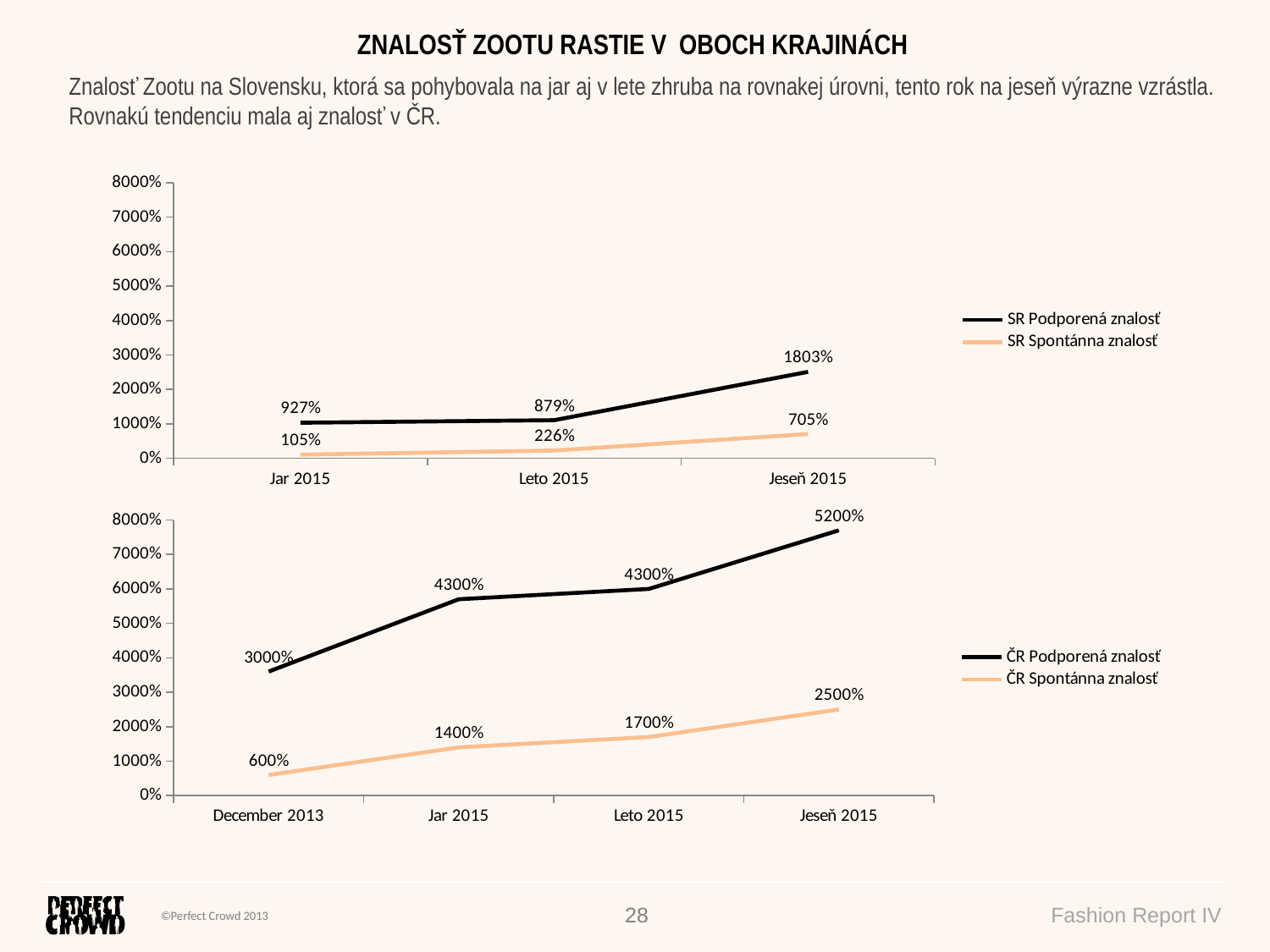
In the bottom chart, what is the value of ČR Podporená znalosť for December 2013? 3000% In the top chart, what is the difference between SR Podporená znalosť and SR Spontánna znalosť for Jar 2015? 822% In the top chart, which period has the lowest value for SR Spontánna znalosť? Jar 2015 In the bottom chart, does ČR Spontánna znalosť rise or fall from December 2013 to Jeseň 2015? rise In the bottom chart, which period has the highest value for ČR Spontánna znalosť? Jeseň 2015 What type of chart is the top chart? line chart How many series does the legend of the bottom chart list? 2 In the bottom chart, what is the value of ČR Spontánna znalosť for Jeseň 2015? 2500% In the top chart, what is the value of SR Podporená znalosť for Jeseň 2015? 1803% In the top chart, how many periods are shown on the x axis? 3 In the bottom chart, what is the difference between ČR Podporená znalosť and ČR Spontánna znalosť for Jeseň 2015? 2700% In the top chart, what is the value of SR Spontánna znalosť for Leto 2015? 226%